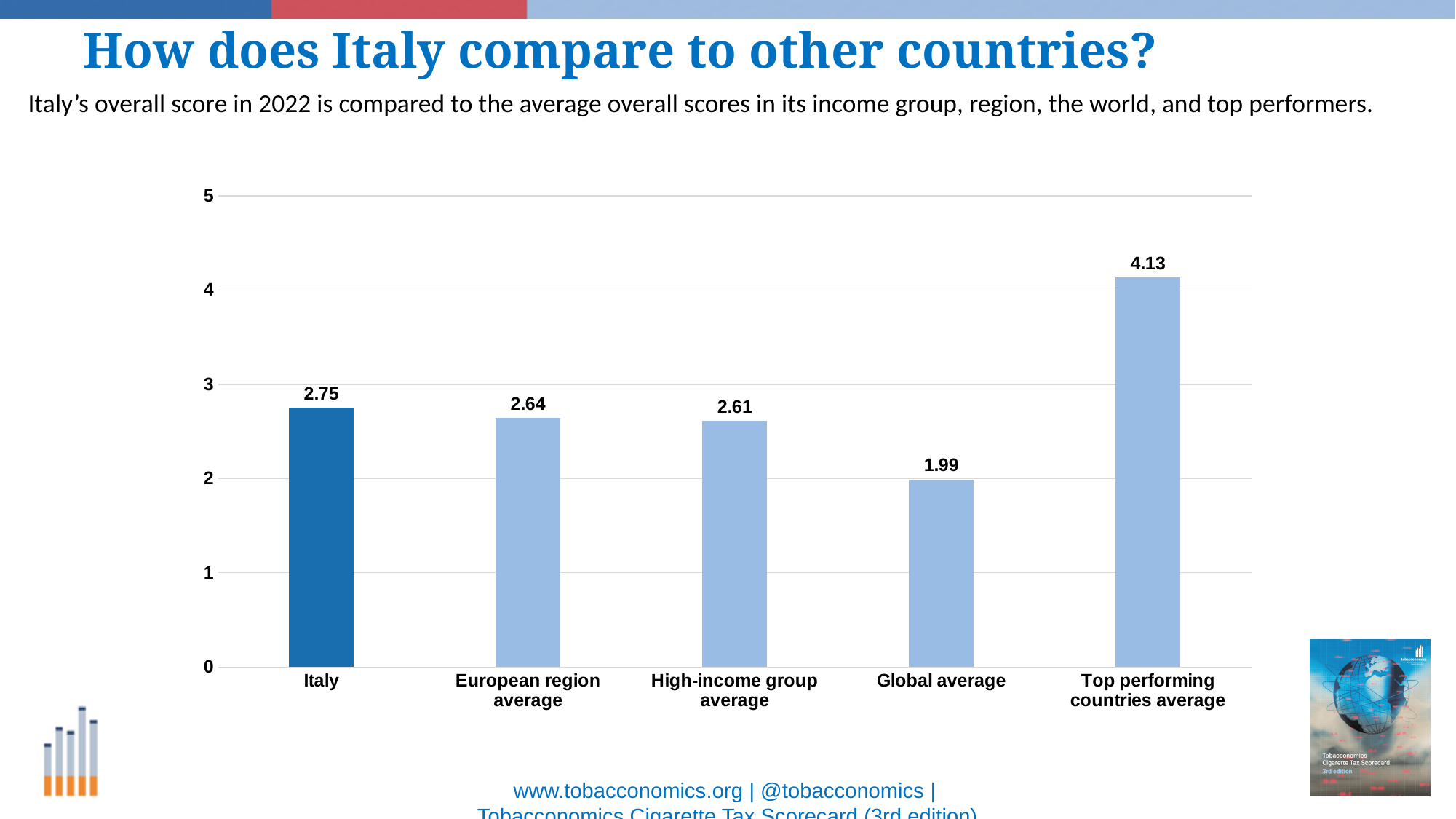
What is the value for Italy? 2.75 Which category has the lowest value? Global average What is the value for the Top performing countries average? 4.13 How many categories are shown on the chart? 5 What is the difference between Italy and the Global average? 0.76 What kind of chart is shown on the slide? Bar chart Is the value for the Top performing countries average greater or less than 4? greater What is the difference between the Top performing countries average and Italy? 1.38 Which category has the highest value? Top performing countries average What is the value for the Global average? 1.99 What is the value for the High-income group average? 2.61 Which is larger, Italy or the European region average? Italy